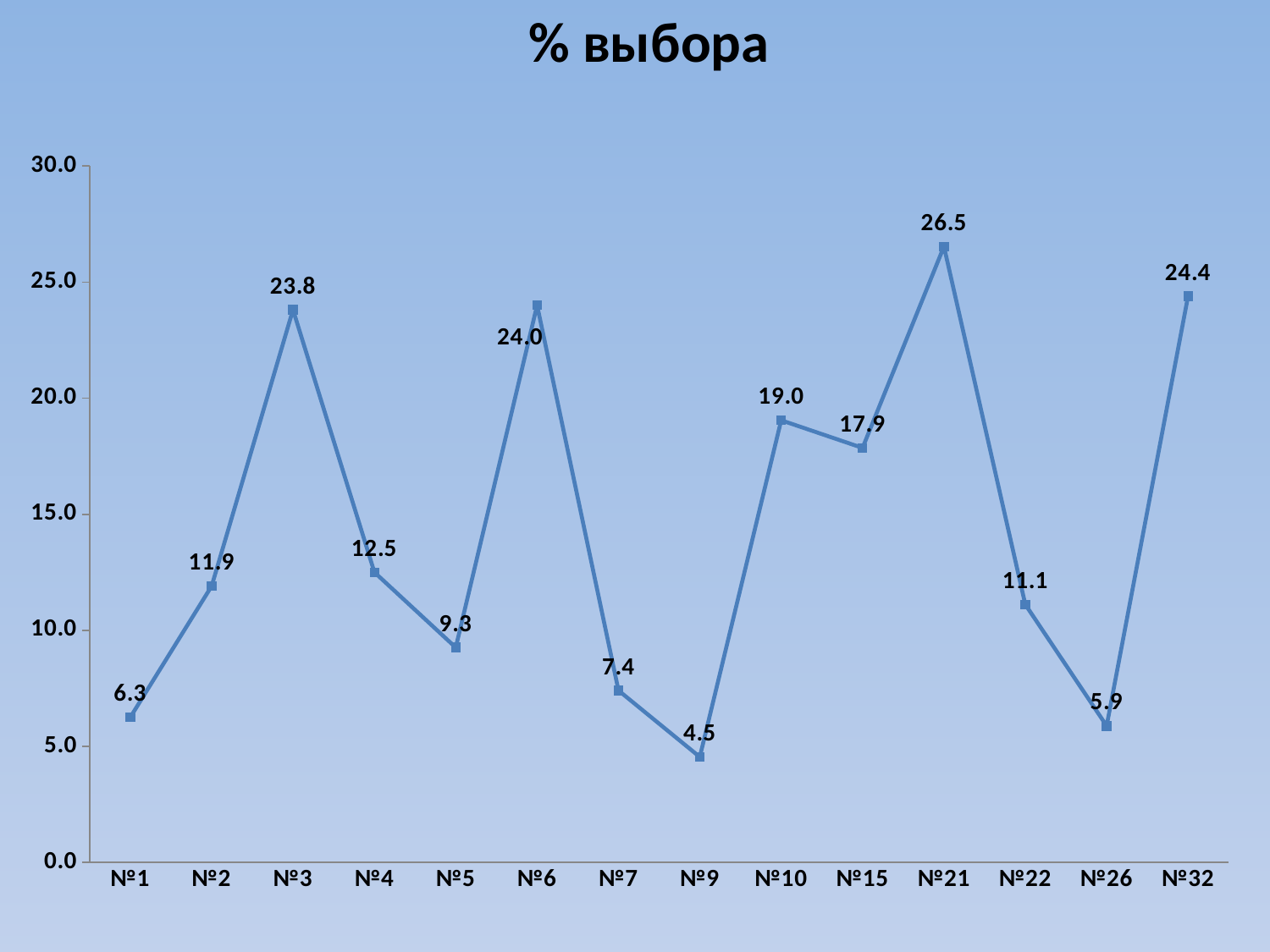
What kind of chart is shown? line chart Which category has the lowest value? №9 How many categories are plotted on the x axis? 14 Which category has the highest value? №21 What is the value for №21? 26.5 What is the value for №9? 4.5 What is the title of the chart? % выбора Does the value rise or fall from №26 to №32? rise Is the value for №6 greater or less than 20.0? greater What is the value for №3? 23.8 What is the difference between the values for №21 and №32? 2.1 Which is larger, the value for №10 or the value for №15? №10